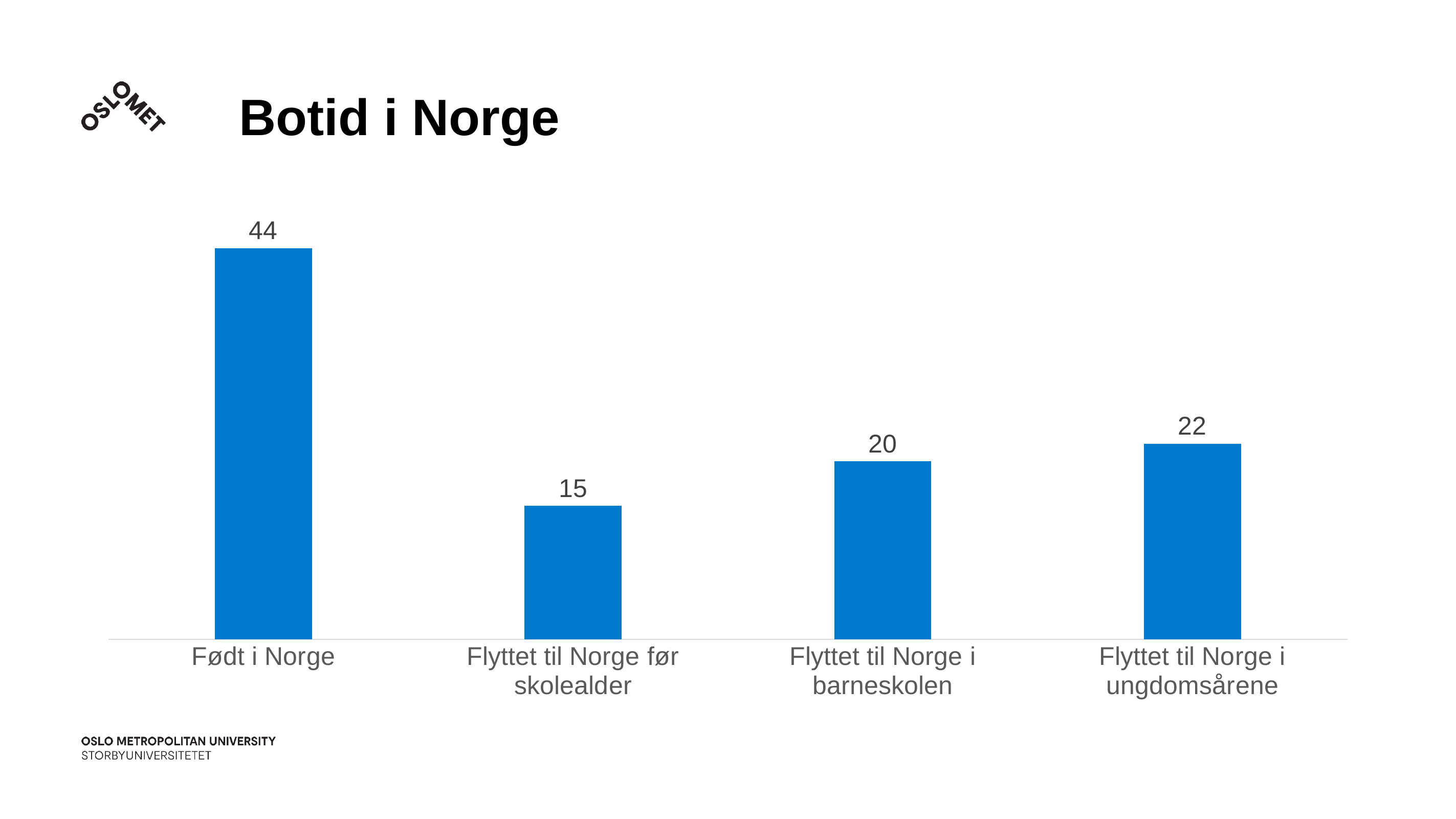
Which category has the highest value? Født i Norge What is the value for Flyttet til Norge i barneskolen? 20 What is the difference between the values for Født i Norge and Flyttet til Norge i ungdomsårene? 22 What is the value for Flyttet til Norge før skolealder? 15 Which category has the lowest value? Flyttet til Norge før skolealder What kind of chart is shown on the slide? Bar chart What is the difference between the values for Flyttet til Norge i barneskolen and Flyttet til Norge før skolealder? 5 What is the value for Født i Norge? 44 What is the title of the slide? Botid i Norge How many categories are shown in the chart? 4 Which is larger, the value for Flyttet til Norge i barneskolen or Flyttet til Norge i ungdomsårene? Flyttet til Norge i ungdomsårene What is the value for Flyttet til Norge i ungdomsårene? 22